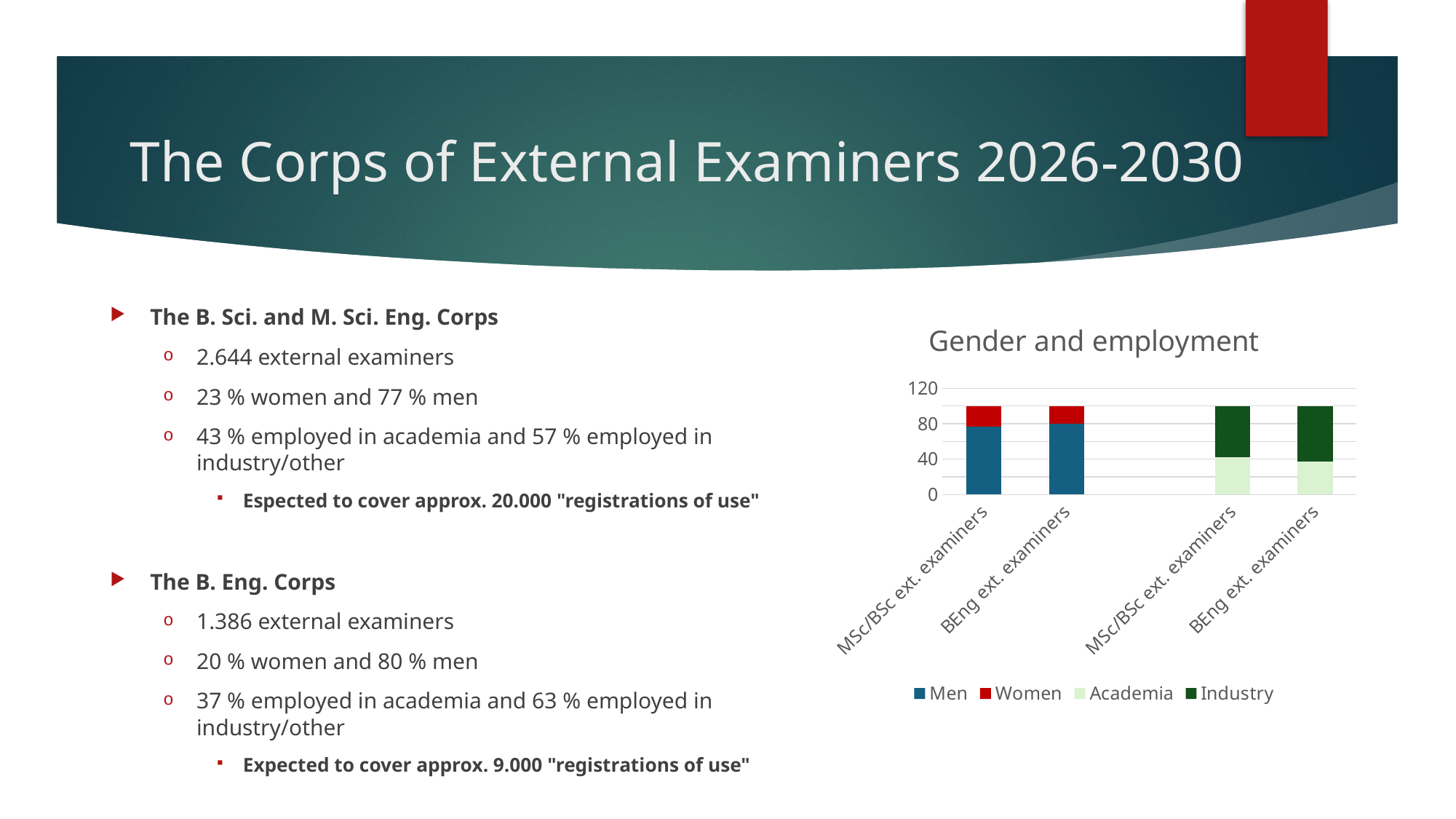
What kind of chart is shown on the slide? Stacked bar chart In the first bar (MSc/BSc ext. examiners), is the Men segment greater or less than 40? greater How many bars are plotted in the chart? 4 What is the title of the chart on the slide? Gender and employment In the second bar (BEng ext. examiners), which segment is larger, Men or Women? Men In the third bar (MSc/BSc ext. examiners), is the Industry segment greater or less than 40? greater Is the total height of the BEng ext. examiners gender bar greater or less than 120? less In the first bar (MSc/BSc ext. examiners), which segment is larger, Men or Women? Men Which series are listed in the chart legend? Men, Women, Academia, Industry In the fourth bar (BEng ext. examiners), which segment is larger, Academia or Industry? Industry How many series does the chart legend list? 4